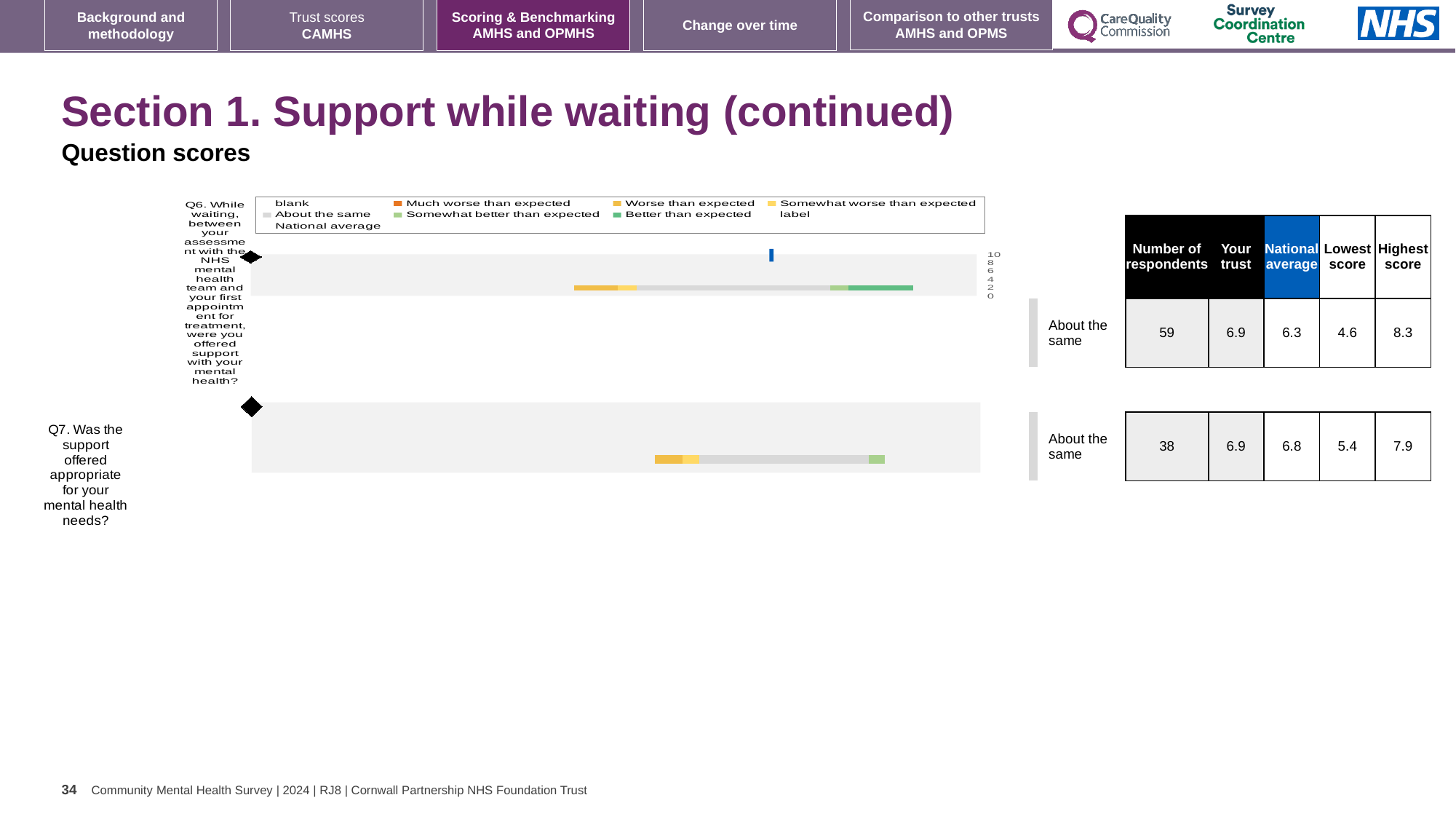
What is the difference between the highest score and the lowest score for Q6? 3.7 Which question has the higher 'Highest score' value, Q6 or Q7? Q6 What is the 'Your trust' score for Q6 (support while waiting between assessment and first appointment)? 6.9 How many respondents answered Q6? 59 By how much does the trust's score for Q6 exceed the national average? 0.6 What is the national average score for Q7 (was the support offered appropriate for your mental health needs)? 6.8 Which colour in the legend represents 'Better than expected'? Green How many questions are plotted in the chart? 2 What benchmark category is shown for Q7? About the same How many respondents answered Q7? 38 For Q6, is the trust's score higher or lower than the national average? Higher What kind of chart is used to show the question scores on this slide? Bar chart